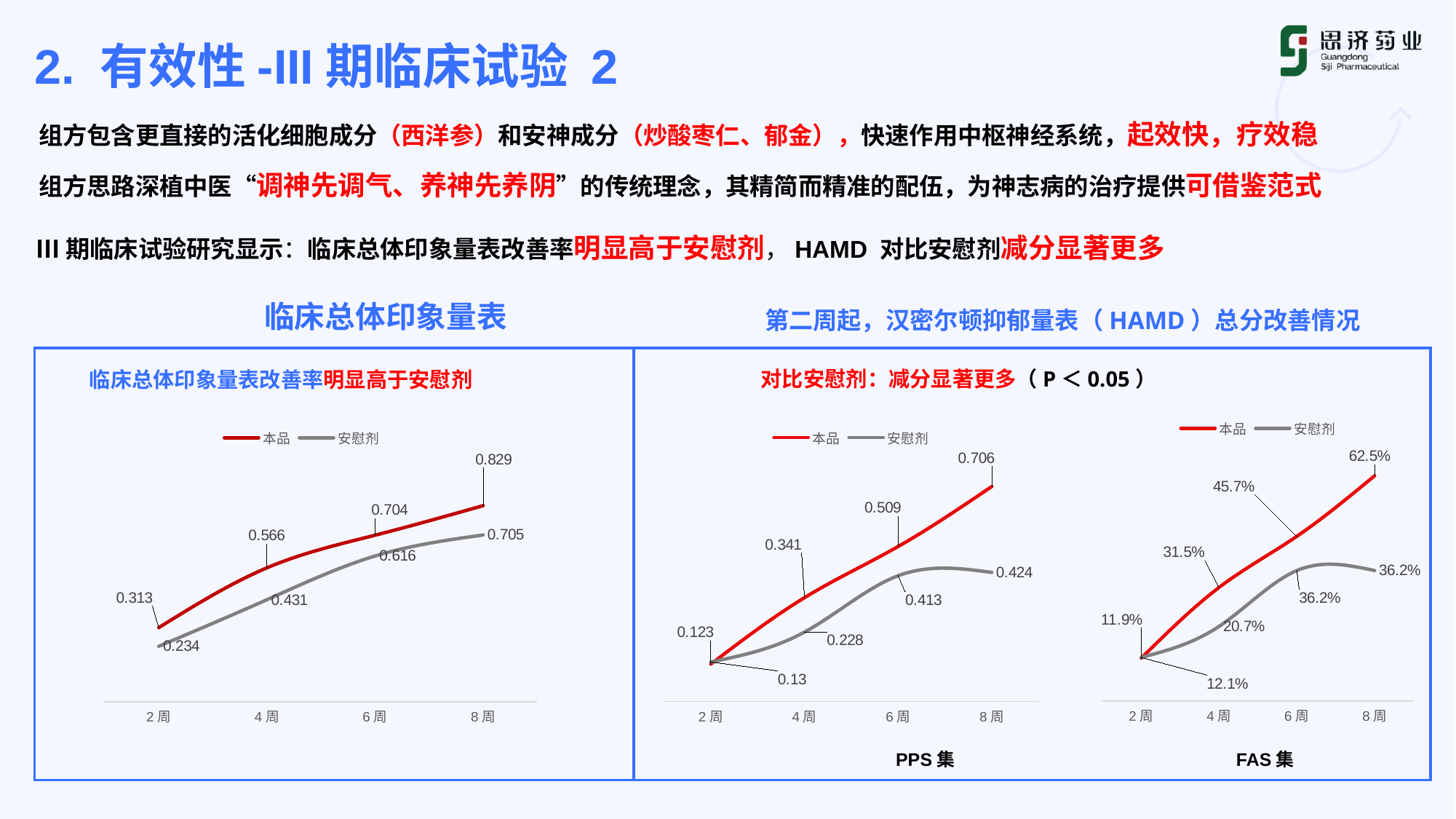
In the 临床总体印象量表 chart on the left, what is the difference between 本品 and 安慰剂 at 8 周? 0.124 In the FAS 集 chart, what is the difference between 本品 and 安慰剂 at 8 周? 26.3% In the 临床总体印象量表 chart on the left, does the 本品 line rise or fall from 2 周 to 8 周? rise In the PPS 集 chart, what is the value for 本品 at 6 周? 0.509 In the PPS 集 chart, what is the value for 安慰剂 at 8 周? 0.424 What type of chart is the PPS 集 chart? line chart In the 临床总体印象量表 chart on the left, what is the value for 安慰剂 at 2 周? 0.234 In the PPS 集 chart, which series has the higher value at 2 周, 本品 or 安慰剂? 安慰剂 In the FAS 集 chart, what is the value for 安慰剂 at 4 周? 20.7% How many time points are shown on the x axis of the FAS 集 chart? 4 In the FAS 集 chart, what is the value for 本品 at 8 周? 62.5% In the 临床总体印象量表 chart on the left, what is the value for 本品 at 8 周? 0.829